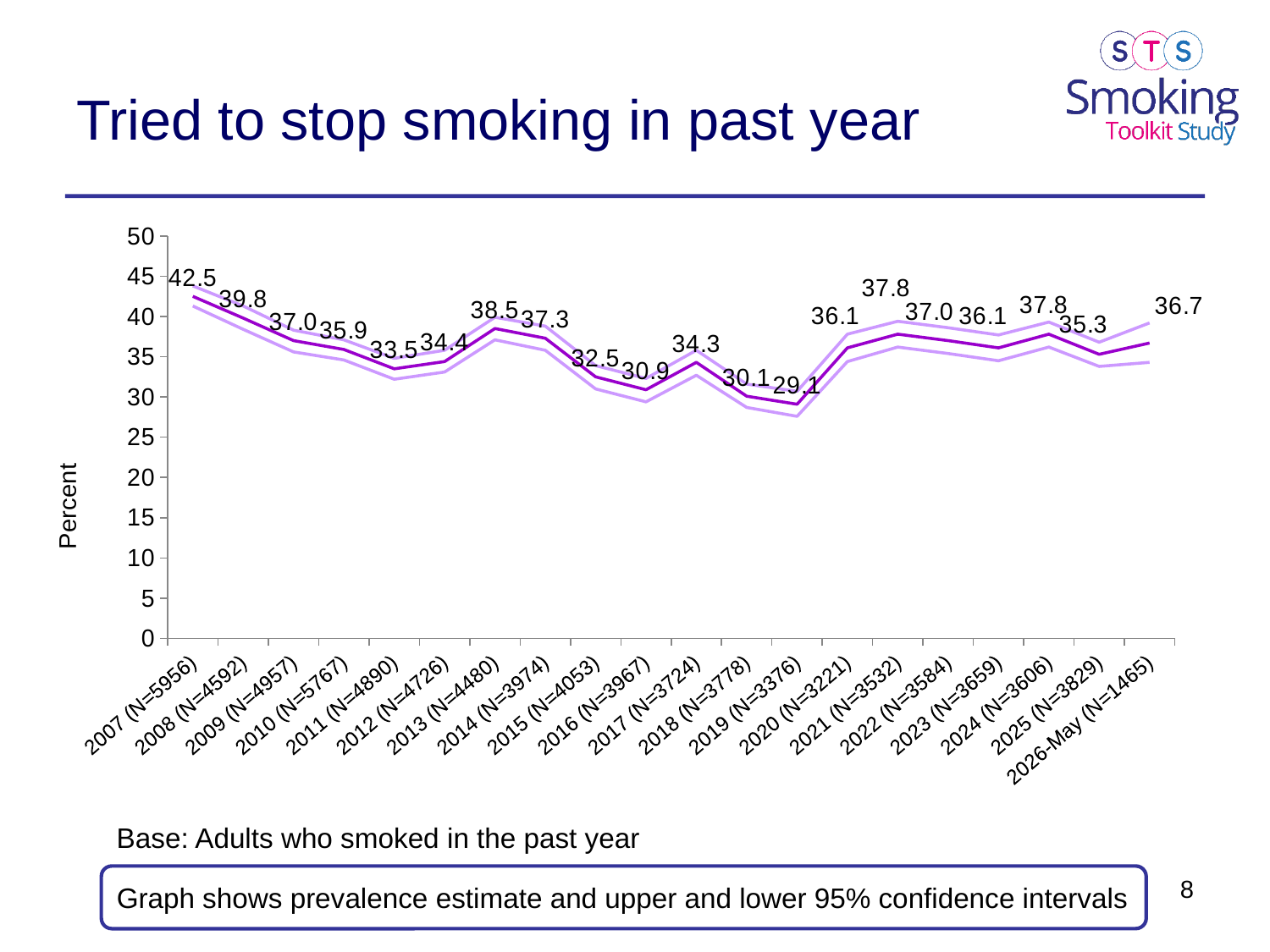
What is the label on the y axis? Percent How many years are plotted on the x axis? 20 What kind of chart is shown? Line chart Does the value rise or fall from 2007 (N=5956) to 2011 (N=4890)? Fall What is the value for 2013 (N=4480)? 38.5 Which year has the lowest value? 2019 (N=3376) What is the value for 2007 (N=5956)? 42.5 Which is larger, the value for 2017 (N=3724) or the value for 2018 (N=3778)? 2017 (N=3724) What is the difference between the values for 2007 (N=5956) and 2019 (N=3376)? 13.4 Which year has the highest value? 2007 (N=5956) What is the value for 2019 (N=3376)? 29.1 What is the value for 2026-May (N=1465)? 36.7